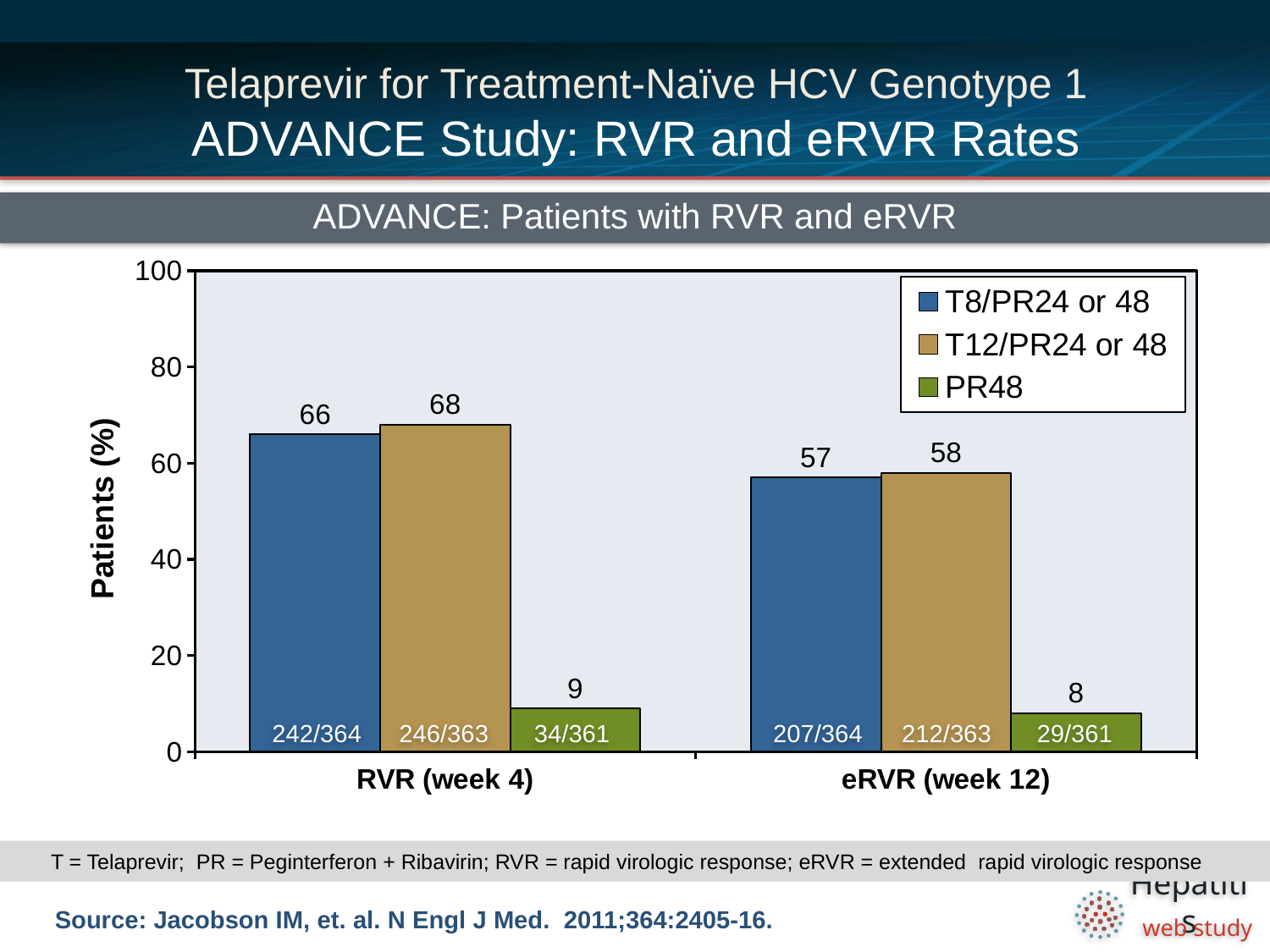
What is the value for T8/PR24 or 48 in the RVR (week 4) group? 66 Is the value for T12/PR24 or 48 in the RVR (week 4) group greater or less than 60? greater What is the difference between the T12/PR24 or 48 value and the PR48 value in the RVR (week 4) group? 59 What is the label of the y axis? Patients (%) Which series has the lowest value in the RVR (week 4) group? PR48 What kind of chart is shown on the slide? Bar chart What is the value for PR48 in the eRVR (week 12) group? 8 Which series has the highest value in the eRVR (week 12) group? T12/PR24 or 48 What is the value for T12/PR24 or 48 in the eRVR (week 12) group? 58 Which is larger: the T8/PR24 or 48 value for RVR (week 4) or the T8/PR24 or 48 value for eRVR (week 12)? RVR (week 4) How many series does the legend list? 3 How many categories are shown on the x axis? 2